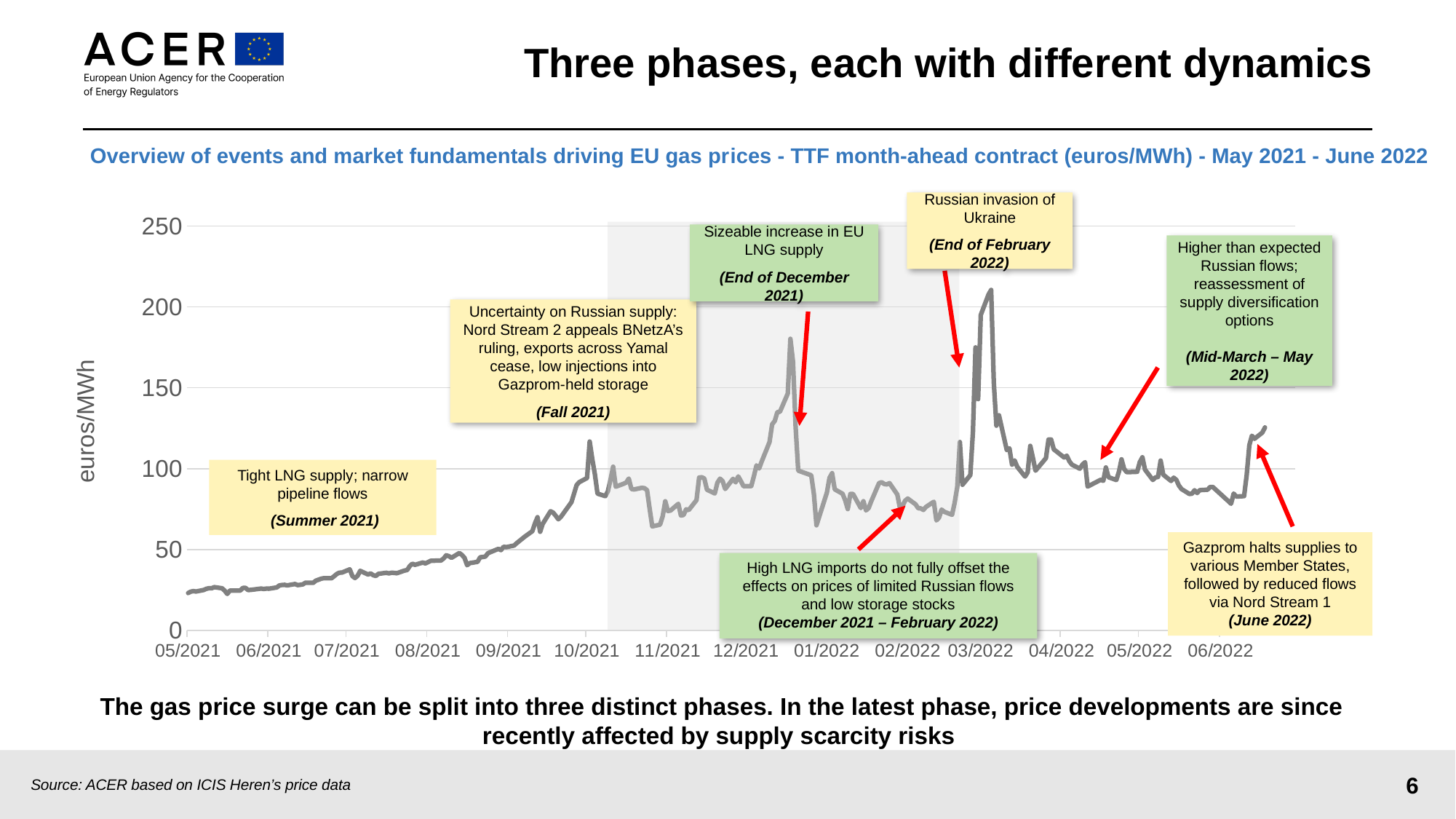
What is the highest value shown on the y-axis of the chart? 250 Is the value in 05/2021 larger or smaller than the value in 06/2022? smaller Is the value at the start of the series in 05/2021 greater or less than 50? less Is the peak value reached in late 12/2021 greater or less than 150? greater What is the label on the y-axis of the chart? euros/MWh In which month is the line at its lowest point? 05/2021 Is the value in 08/2021 greater or less than 50? less What kind of chart is shown on the slide? line chart In which month does the line reach its highest point? 03/2022 Does the price rise or fall between 05/2021 and 10/2021? rise